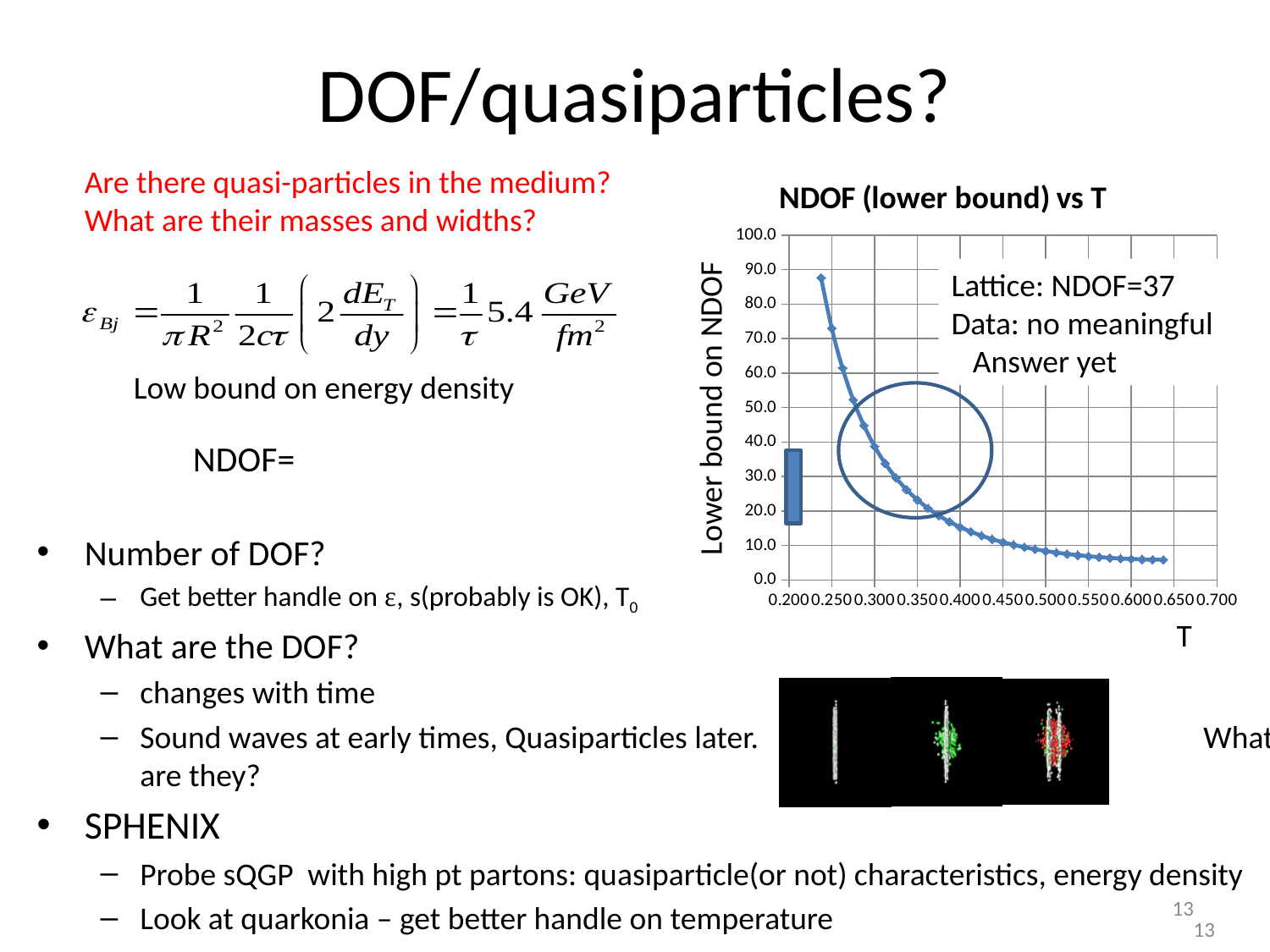
Is the lower bound on NDOF at T = 0.600 greater or less than 10.0? less What is the highest value shown on the vertical axis of the chart? 100.0 What is the label of the vertical axis of the chart? Lower bound on NDOF What is the title of the chart? NDOF (lower bound) vs T Which has the larger lower bound on NDOF: T = 0.300 or T = 0.600? T = 0.300 Is the lower bound on NDOF at T = 0.500 greater or less than 20.0? less Is the lower bound on NDOF at T = 0.300 greater or less than 30.0? greater At which end of the T axis does the curve reach its highest lower bound on NDOF, the low-T end or the high-T end? the low-T end Does the lower bound on NDOF rise or fall as T increases along the x axis? fall What kind of chart is shown on the slide? line chart